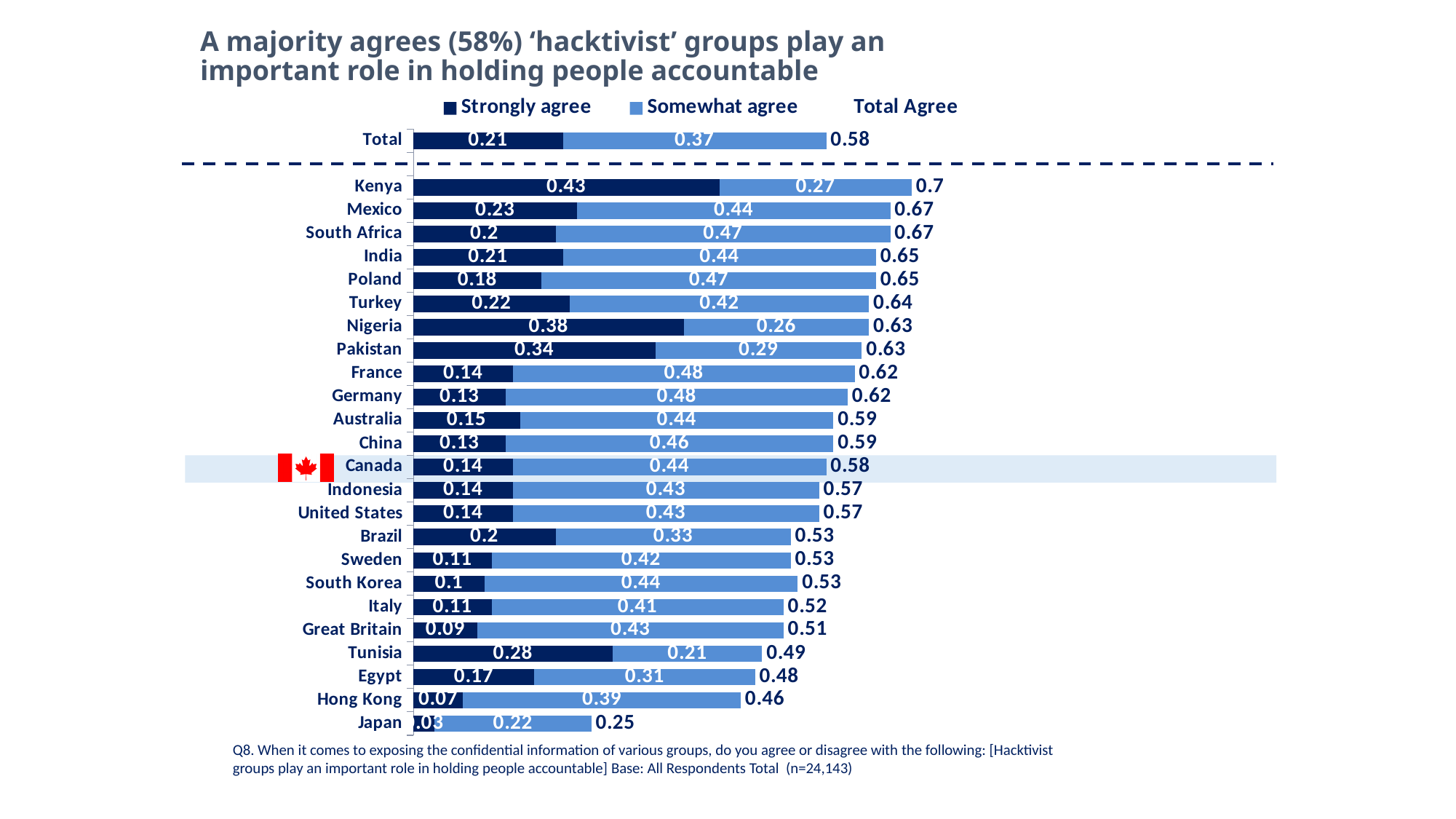
What is the difference between the Total Agree values for Kenya and Japan? 0.45 How many countries are listed below the dashed line? 24 What is the Strongly agree value for Kenya? 0.43 What is the Total Agree value for Canada? 0.58 Which country has the highest Total Agree value? Kenya What is the Somewhat agree value for Germany? 0.48 How many entries does the legend show? 3 Which has a larger Strongly agree value, Nigeria or Pakistan? Nigeria What is the Somewhat agree value for Hong Kong? 0.39 What is the total of the stacked bar for Tunisia? 0.49 What kind of chart is shown on the slide? Stacked bar chart Which country has the lowest Total Agree value? Japan